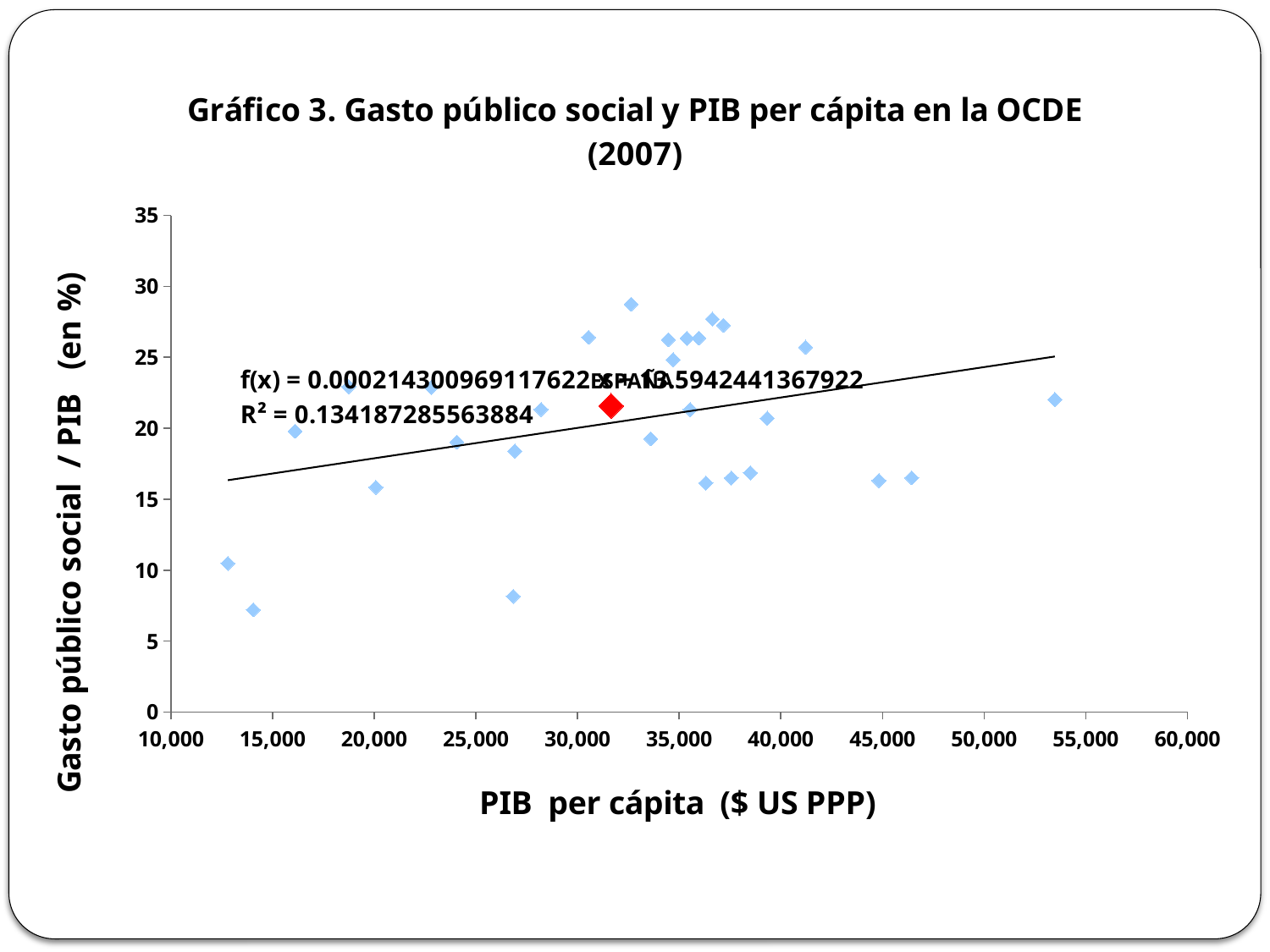
Does the fitted trend line rise or fall as PIB per cápita increases? Rises What kind of chart is shown on the slide? Scatter chart What is the label of the horizontal axis? PIB per cápita ($ US PPP) Is the social spending value for the red ESPAÑA point greater or less than 25? less Is the highest social spending value plotted greater or less than 25? greater Is the lowest social spending value plotted greater or less than 10? less What R² value is printed on the chart? R² = 0.134187285563884 What is the title of the chart? Gráfico 3. Gasto público social y PIB per cápita en la OCDE (2007)